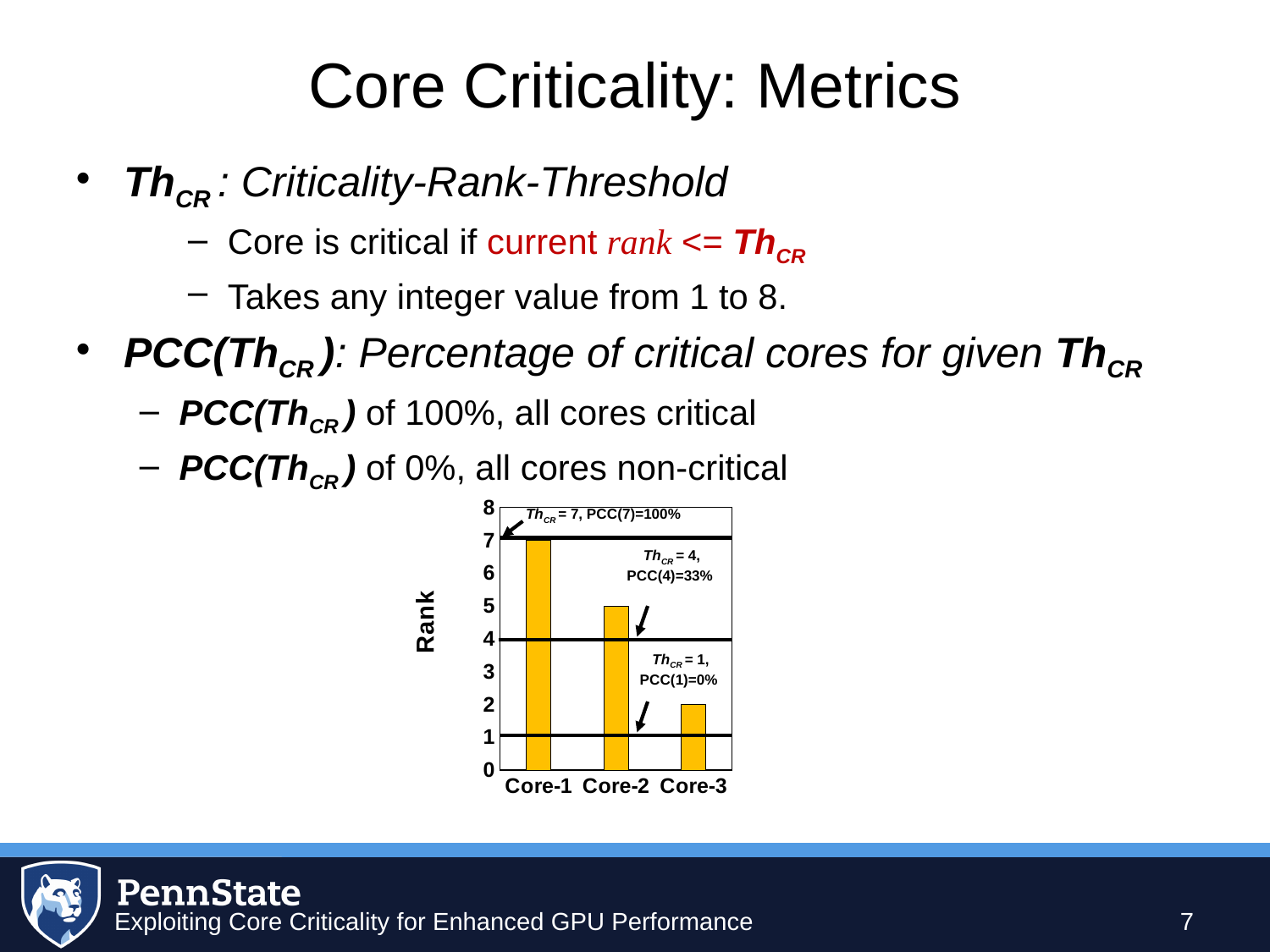
What is the rank of Core-1 in the chart? 7 What is the rank of Core-2 in the chart? 5 What is the label of the y axis of the chart? Rank Which core has the highest rank in the chart? Core-1 Do the ranks rise or fall from Core-1 to Core-3 along the x axis? fall What kind of chart is shown on the slide? bar chart Which core has the lowest rank in the chart? Core-3 How many cores are shown on the x axis of the chart? 3 Is the rank of Core-2 greater or less than 4? greater What is the difference in rank between Core-1 and Core-3? 5 What is the rank of Core-3 in the chart? 2 Which has a higher rank, Core-2 or Core-3? Core-2